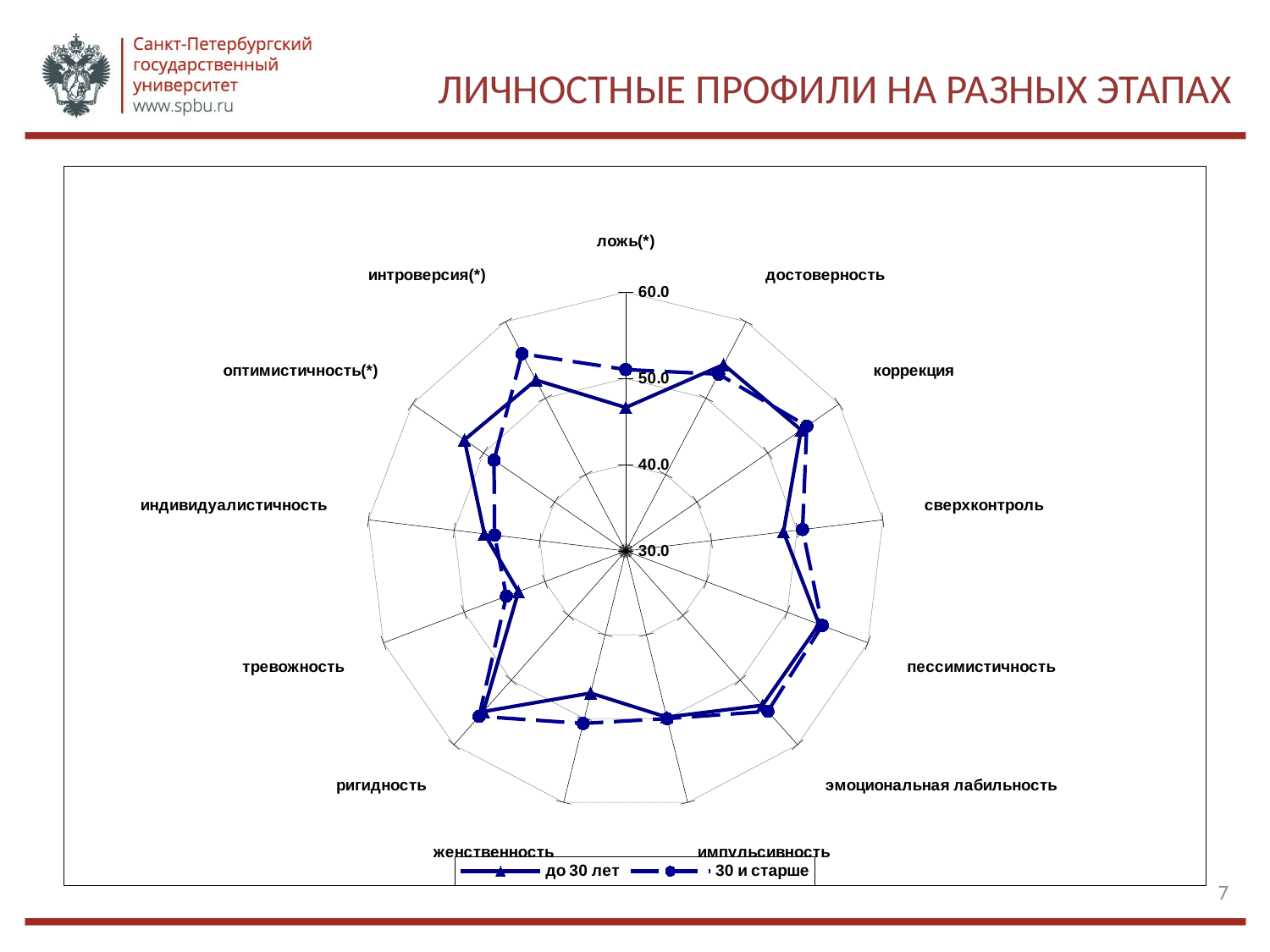
For оптимистичность(*), which series has the larger value: до 30 лет or 30 и старше? до 30 лет Is the value for тревожность in the series 30 и старше greater or less than 40.0? greater For ложь(*), which series has the larger value: до 30 лет or 30 и старше? 30 и старше Which series is drawn with a dashed line and circle markers? 30 и старше Is the value for ригидность in the series 30 и старше greater or less than 50.0? greater How many categories (axes) does the radar chart have? 13 Is the value for эмоциональная лабильность in the series до 30 лет greater or less than 50.0? greater How many series does the legend list? 2 What kind of chart is shown on the slide? Radar chart What is the title of the slide containing the chart? ЛИЧНОСТНЫЕ ПРОФИЛИ НА РАЗНЫХ ЭТАПАХ